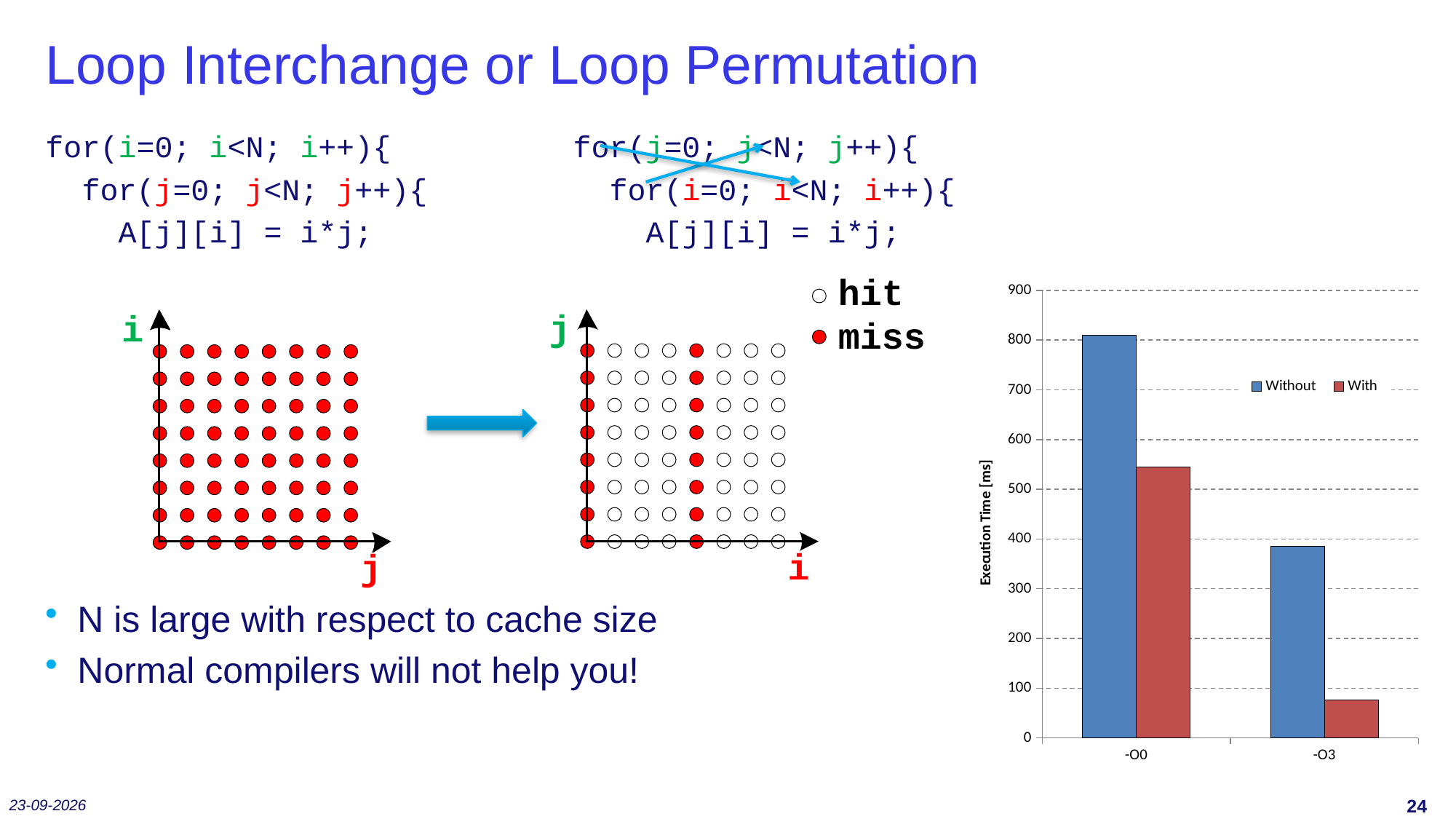
In the bar chart, is the execution time for Without at -O3 greater or less than 400? less What is the label of the vertical axis of the bar chart? Execution Time [ms] Which series and category has the lowest execution time in the bar chart? With, -O3 Which series and category has the highest execution time in the bar chart? Without, -O0 What kind of chart is shown on the right side of the slide? bar chart In the bar chart, is the execution time for With at -O0 greater or less than 500? greater How many categories are shown on the x axis of the bar chart? 2 How many series does the legend of the bar chart list? 2 In the bar chart, is the execution time for Without at -O0 greater or less than 800? greater In the bar chart, which is larger at -O3: the Without bar or the With bar? Without Which colour represents the With series in the bar chart? red